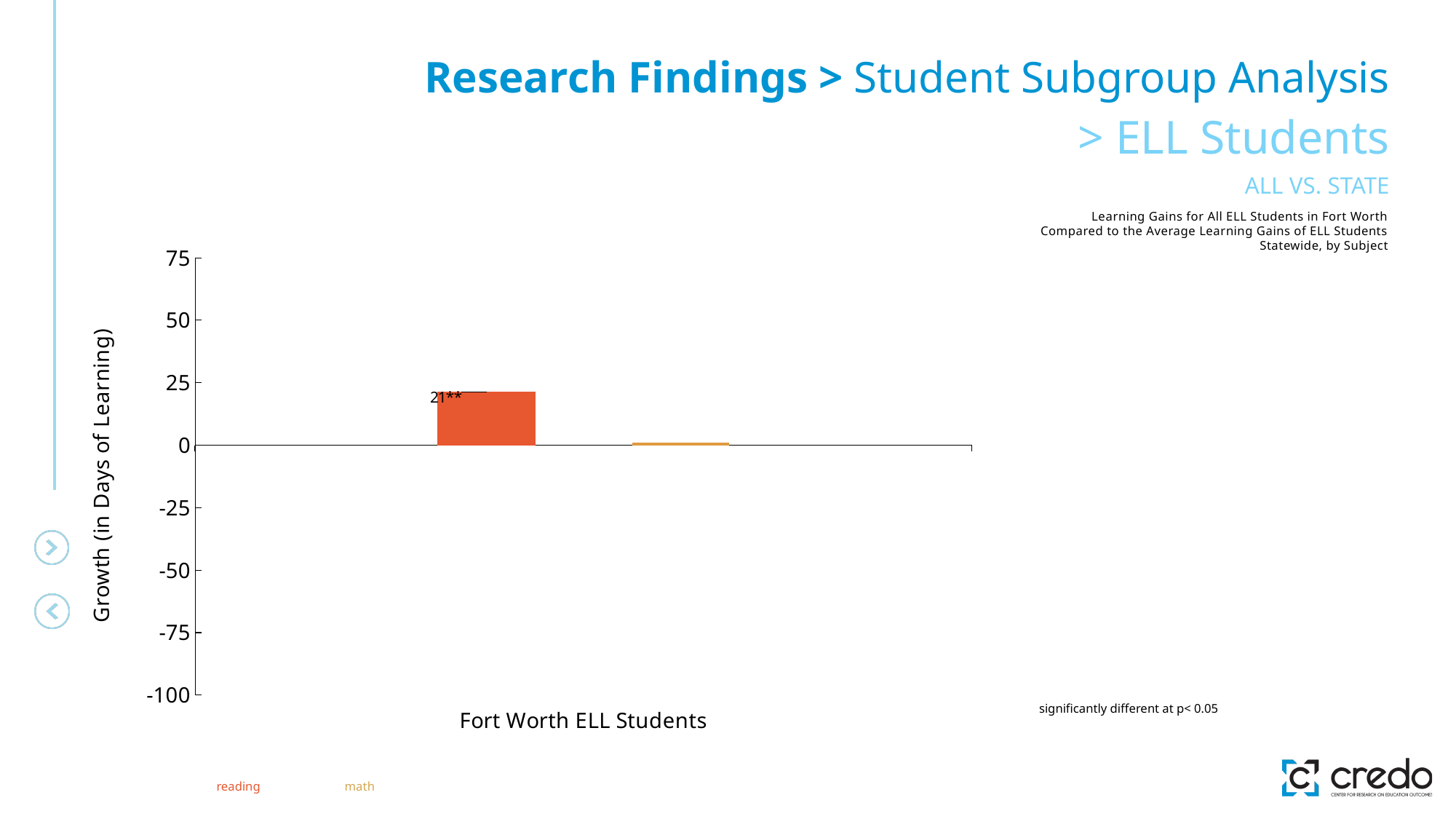
Is the value for math greater or less than 25? less What is the value of the reading bar for Fort Worth ELL Students? 21** What type of chart is shown on the slide? bar chart Is the value for reading greater or less than 0? greater What is the label of the y axis? Growth (in Days of Learning) How many categories are shown on the x axis? 1 Is the value for reading greater or less than 25? less How many series does the legend list? 2 What is the category label shown on the x axis? Fort Worth ELL Students Which series shows the lowest growth for Fort Worth ELL Students? math Which series has the higher value for Fort Worth ELL Students, reading or math? reading